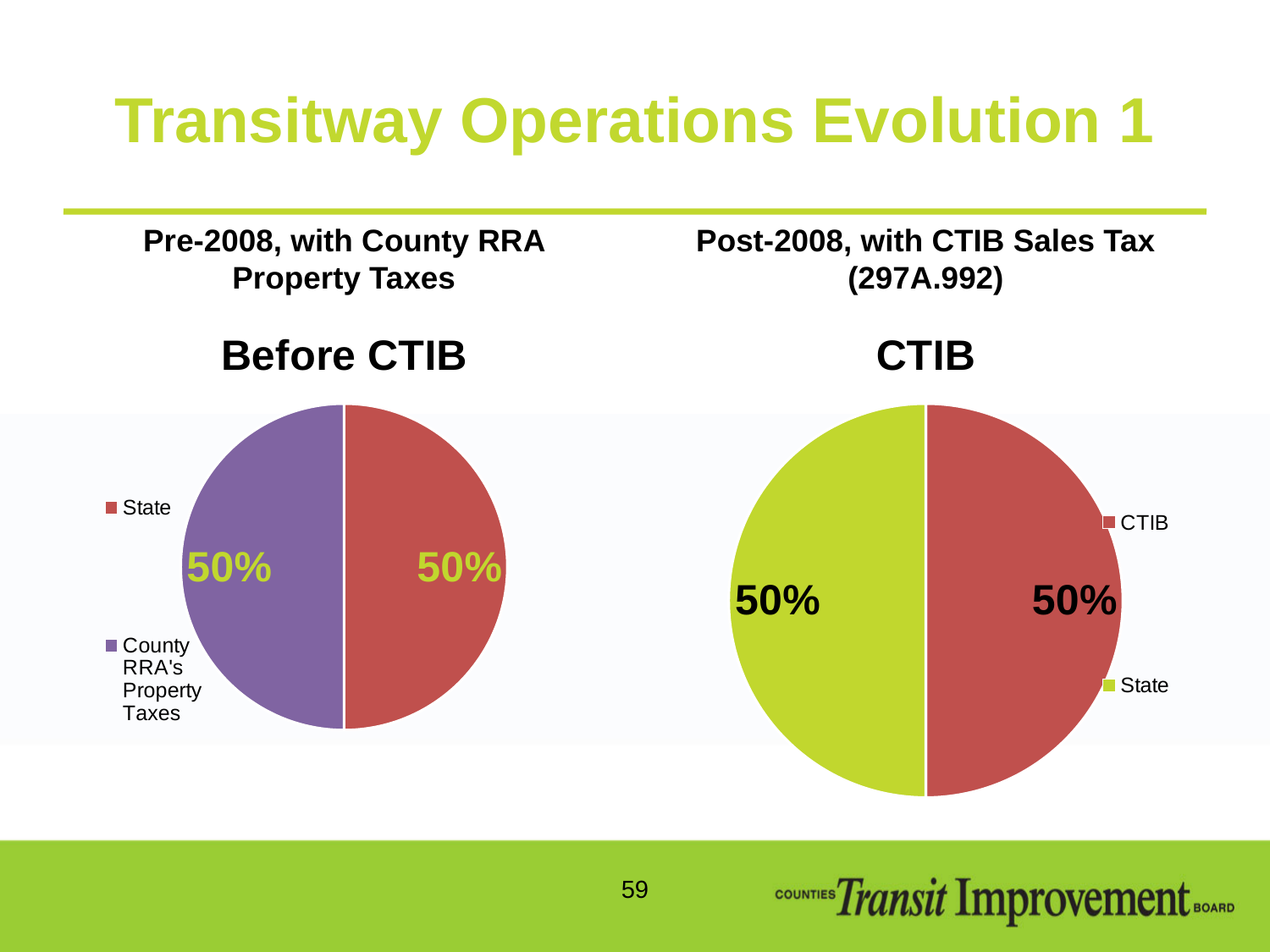
How many slices does the 'Before CTIB' chart have? 2 In the 'CTIB' chart, what share does CTIB have? 50% What kind of chart is the 'CTIB' chart? Pie chart What is the title of the pie chart on the left side of the slide? Before CTIB What are the two legend entries in the 'CTIB' chart? CTIB and State In the 'Before CTIB' chart, what share does State have? 50% How many slices does the 'CTIB' chart have? 2 In the 'Before CTIB' chart, what share does County RRA's Property Taxes have? 50% In the 'Before CTIB' chart, what is the difference between the State share and the County RRA's Property Taxes share? 0% What kind of chart is the 'Before CTIB' chart? Pie chart In the 'CTIB' chart, what is the total of the CTIB and State shares? 100%